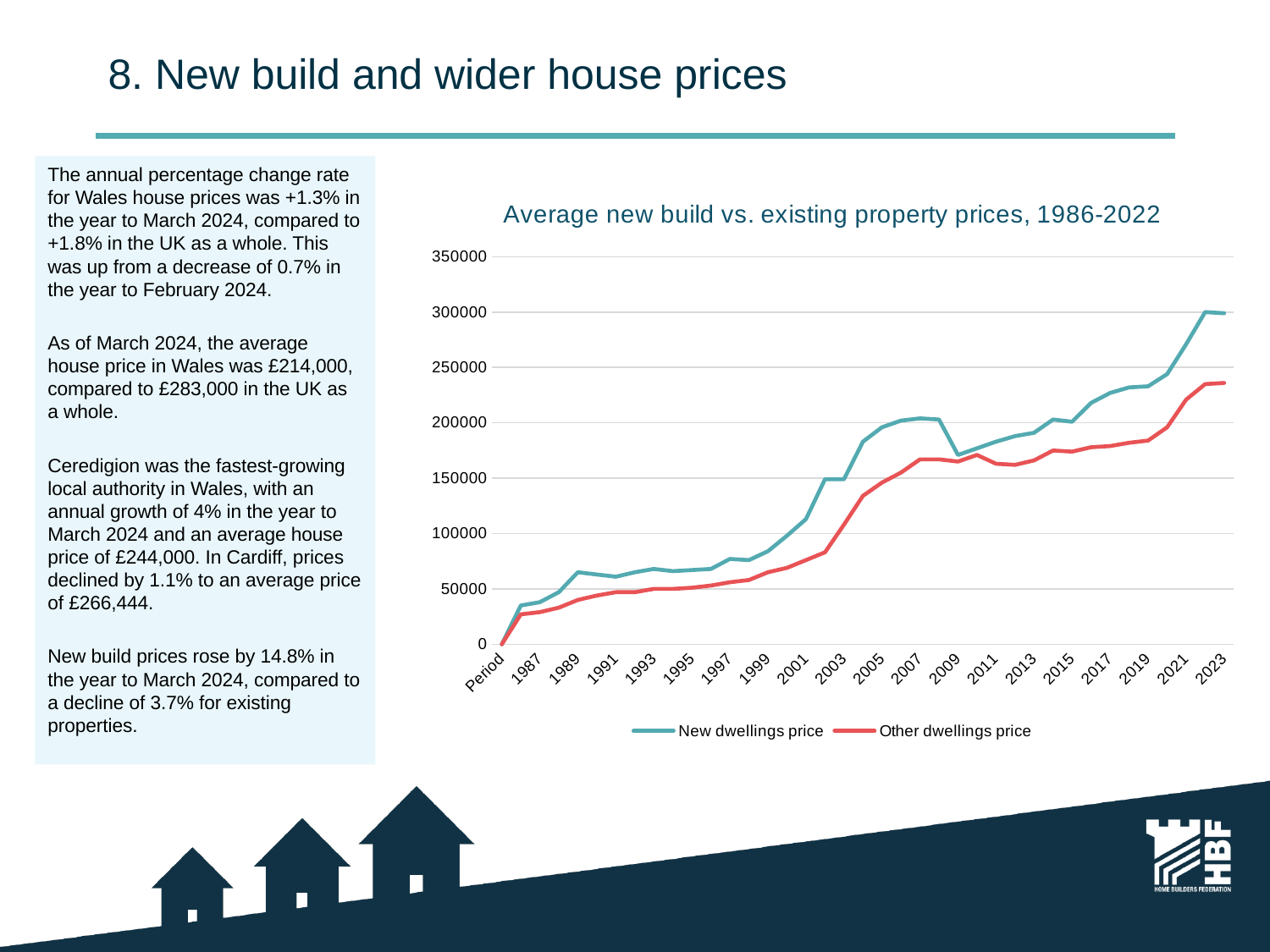
Which series is drawn in red on the chart? Other dwellings price Is the New dwellings price in 2019 greater or less than 250000? less Is the Other dwellings price in 2023 greater or less than 250000? less How many series does the chart's legend list? 2 Which series is lower in 2011, New dwellings price or Other dwellings price? Other dwellings price Is the Other dwellings price in 2023 greater or less than 200000? greater Which series is higher in 2023, New dwellings price or Other dwellings price? New dwellings price Overall, does the New dwellings price rise or fall from 1987 to 2023? Rise What is the title of the chart? Average new build vs. existing property prices, 1986-2022 What kind of chart is shown on the slide? Line chart